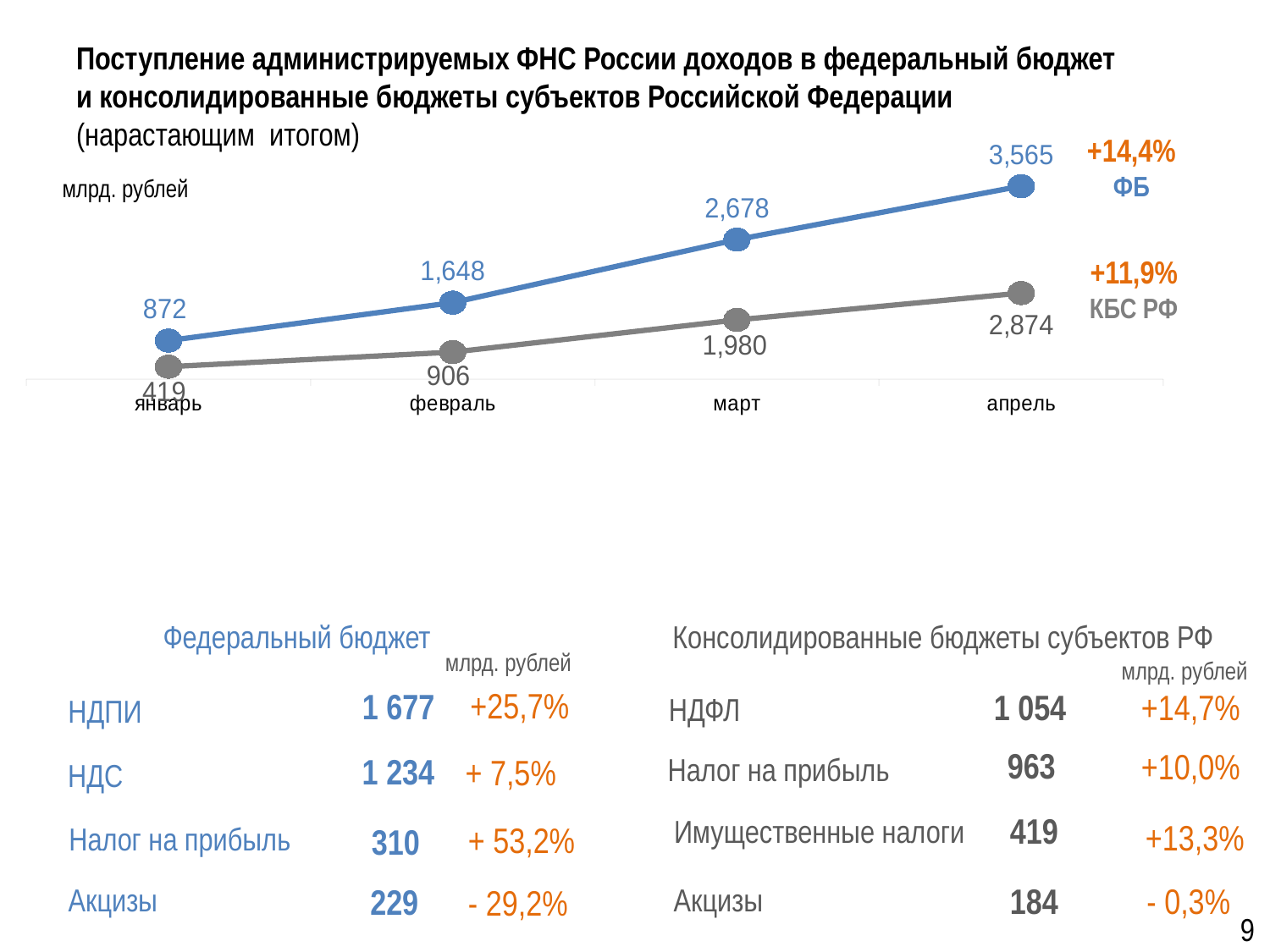
In which month is the ФБ value highest? апрель What is the value for ФБ in апрель? 3,565 How many series (lines) are plotted on the chart? 2 What is the value for КБС РФ in март? 1,980 In which month is the КБС РФ value lowest? январь Do the КБС РФ values rise or fall from январь to апрель? rise Which is larger in март: the ФБ value or the КБС РФ value? ФБ What is the value for ФБ in февраль? 1,648 What is the difference between the ФБ and КБС РФ values in апрель? 691 How many months are plotted on the x axis of the chart? 4 What is the value for КБС РФ in январь? 419 What type of chart is shown at the top of the slide? line chart